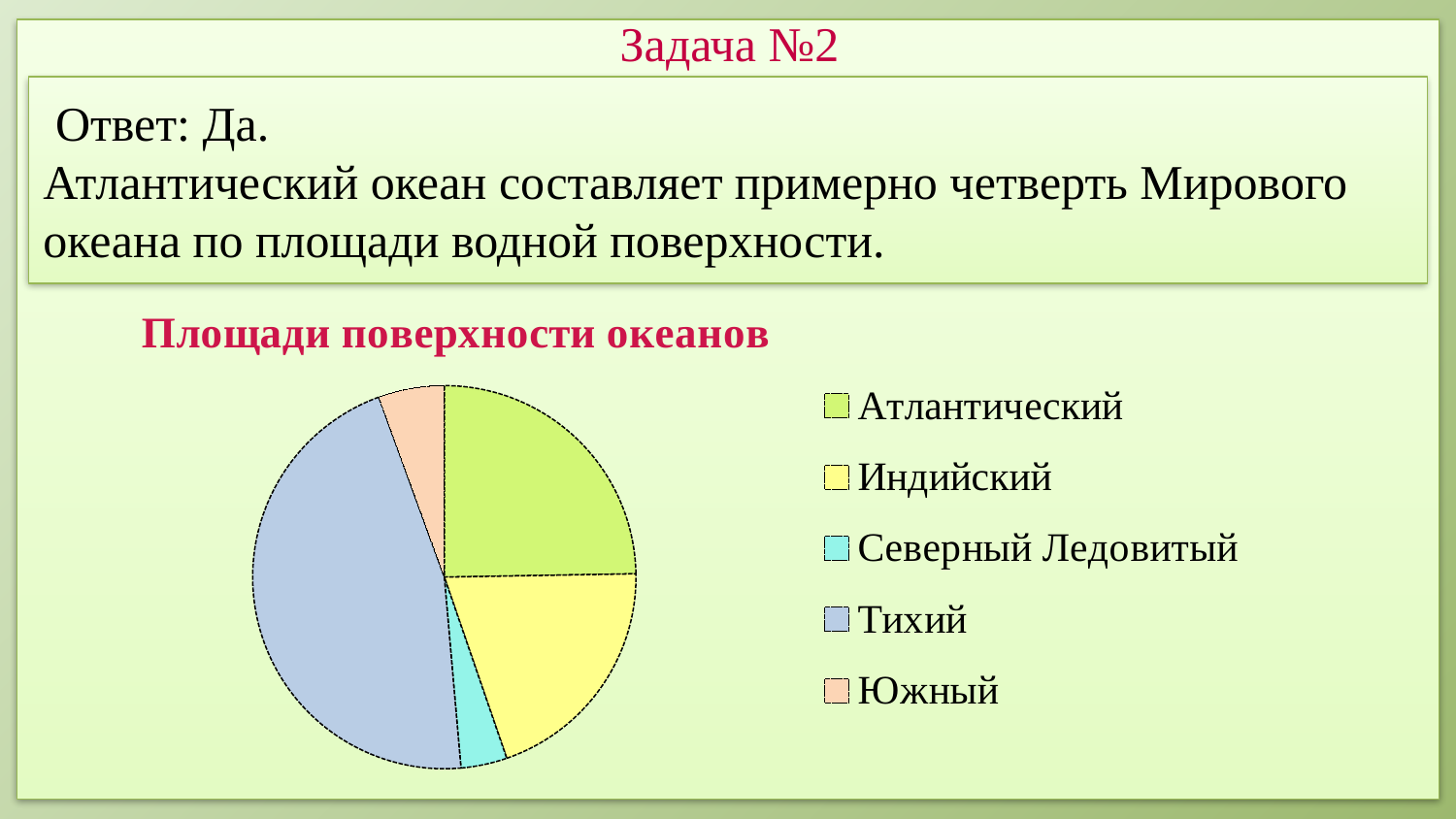
How many entries does the legend list? 5 Which slice is larger: Индийский or Южный? Индийский Which slice is larger: Тихий or Атлантический? Тихий What colour is the slice for Тихий? blue What is the title of the chart? Площади поверхности океанов Which slice is larger: Северный Ледовитый or Тихий? Тихий What kind of chart is shown on the slide? pie chart Which ocean has the largest slice in the pie chart? Тихий How many slices does the pie chart have? 5